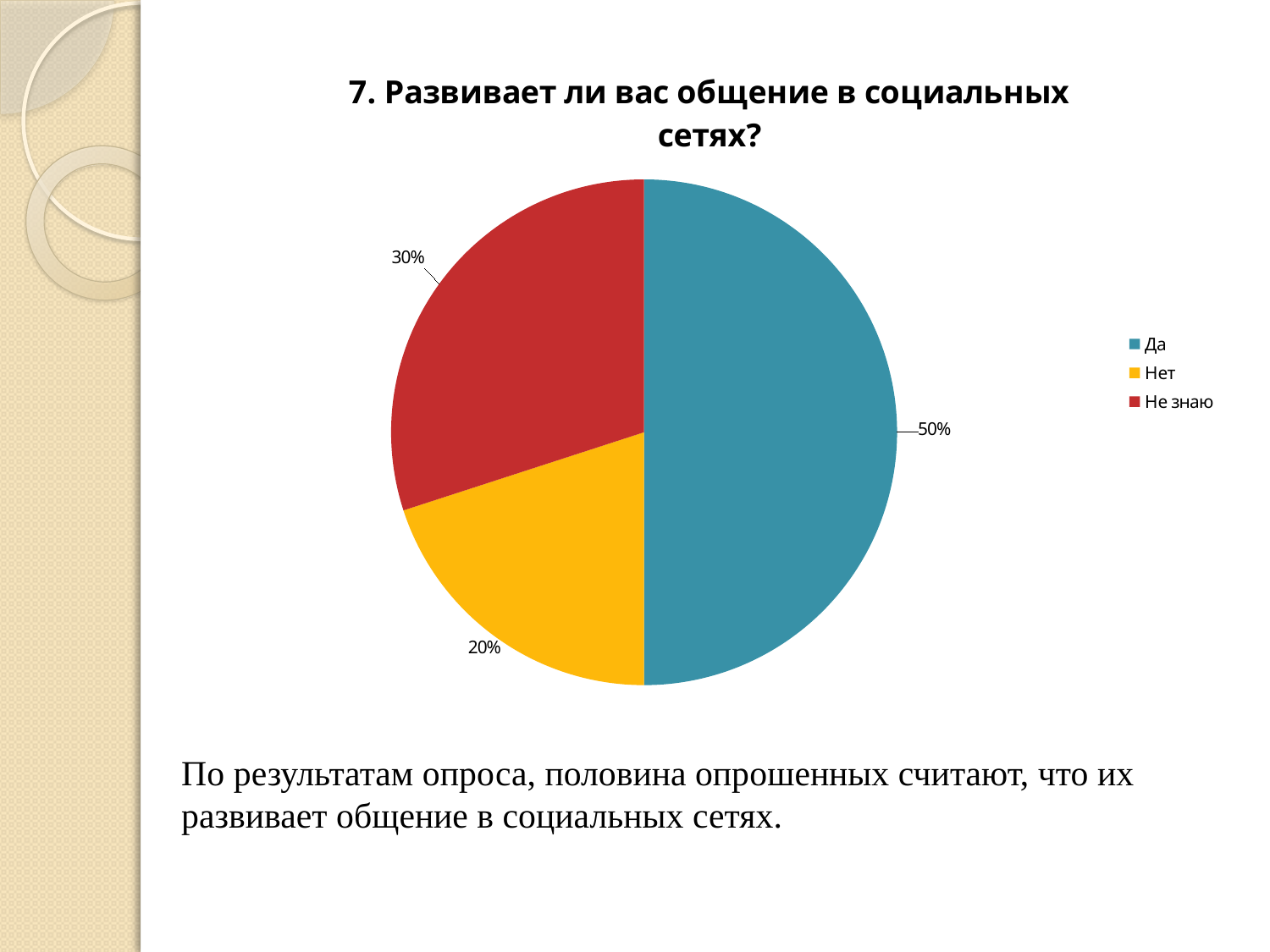
Which answer has the smallest share of the pie? Нет What colour is the "Нет" slice? yellow What is the difference in percentage points between the "Не знаю" and "Нет" slices? 10 What share of respondents answered "Не знаю"? 30% What is the difference in percentage points between the "Да" and "Нет" slices? 30 Which answer has the largest share of the pie? Да What is the title of the chart? 7. Развивает ли вас общение в социальных сетях? What kind of chart is shown on the slide? pie chart What share of respondents answered "Нет"? 20% How many slices does the pie chart have? 3 Which slice is larger, "Не знаю" or "Нет"? Не знаю What share of respondents answered "Да"? 50%